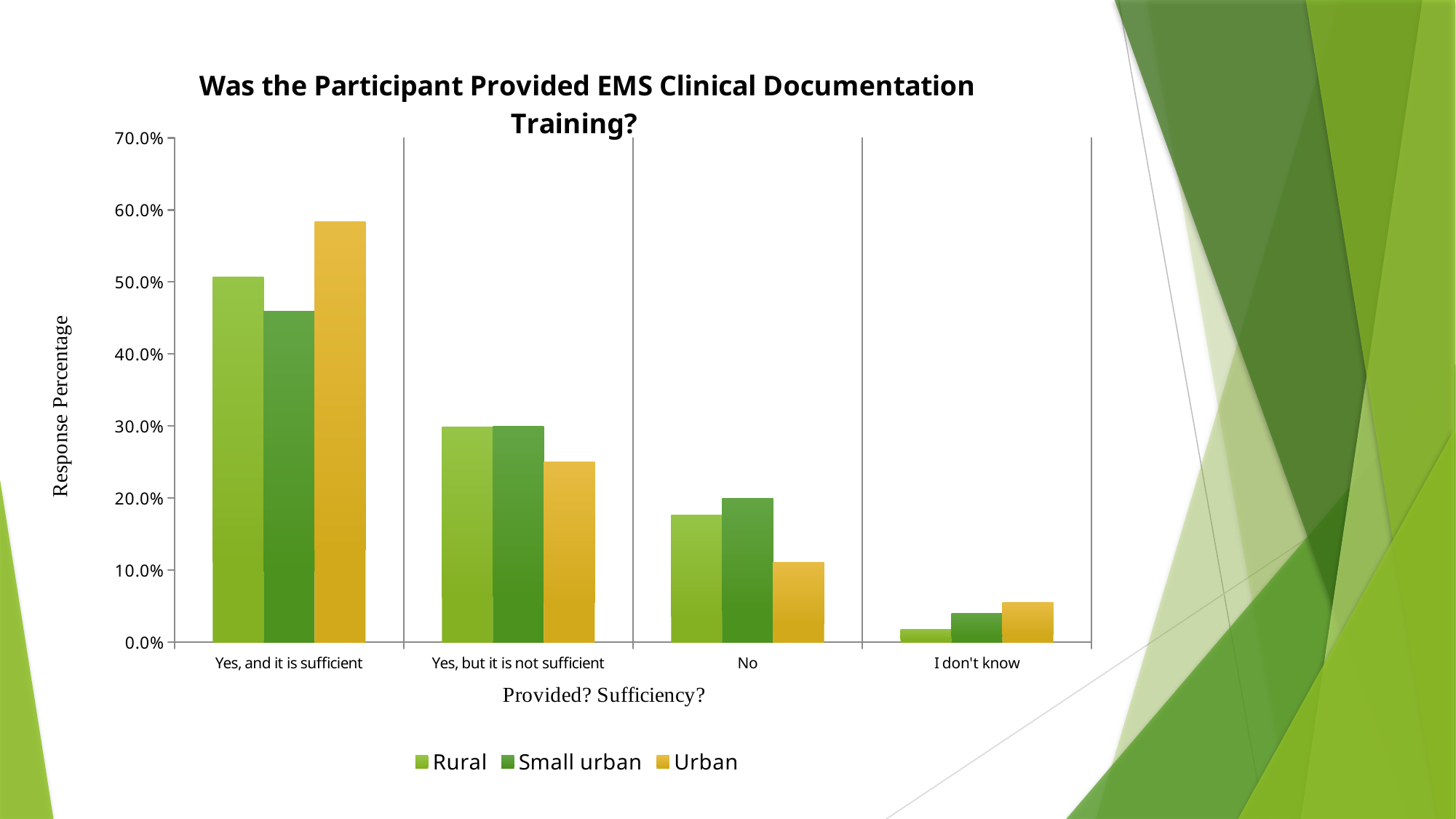
Is the Small urban value for "Yes, and it is sufficient" greater or less than 50.0%? less For "Yes, and it is sufficient", which is larger: the Rural value or the Small urban value? Rural What is the title of the vertical axis? Response Percentage How many response categories are shown on the x axis? 4 Do the Rural values rise or fall moving from left to right across the categories? fall Which series has the lowest value for "No"? Urban How many series does the legend list? 3 Is the Urban value for "Yes, and it is sufficient" greater or less than 50.0%? greater Which series has the lowest value for "I don't know"? Rural Is the Urban value for "No" greater or less than 20.0%? less Which series has the highest value for "Yes, and it is sufficient"? Urban What kind of chart is shown on the slide? Bar chart